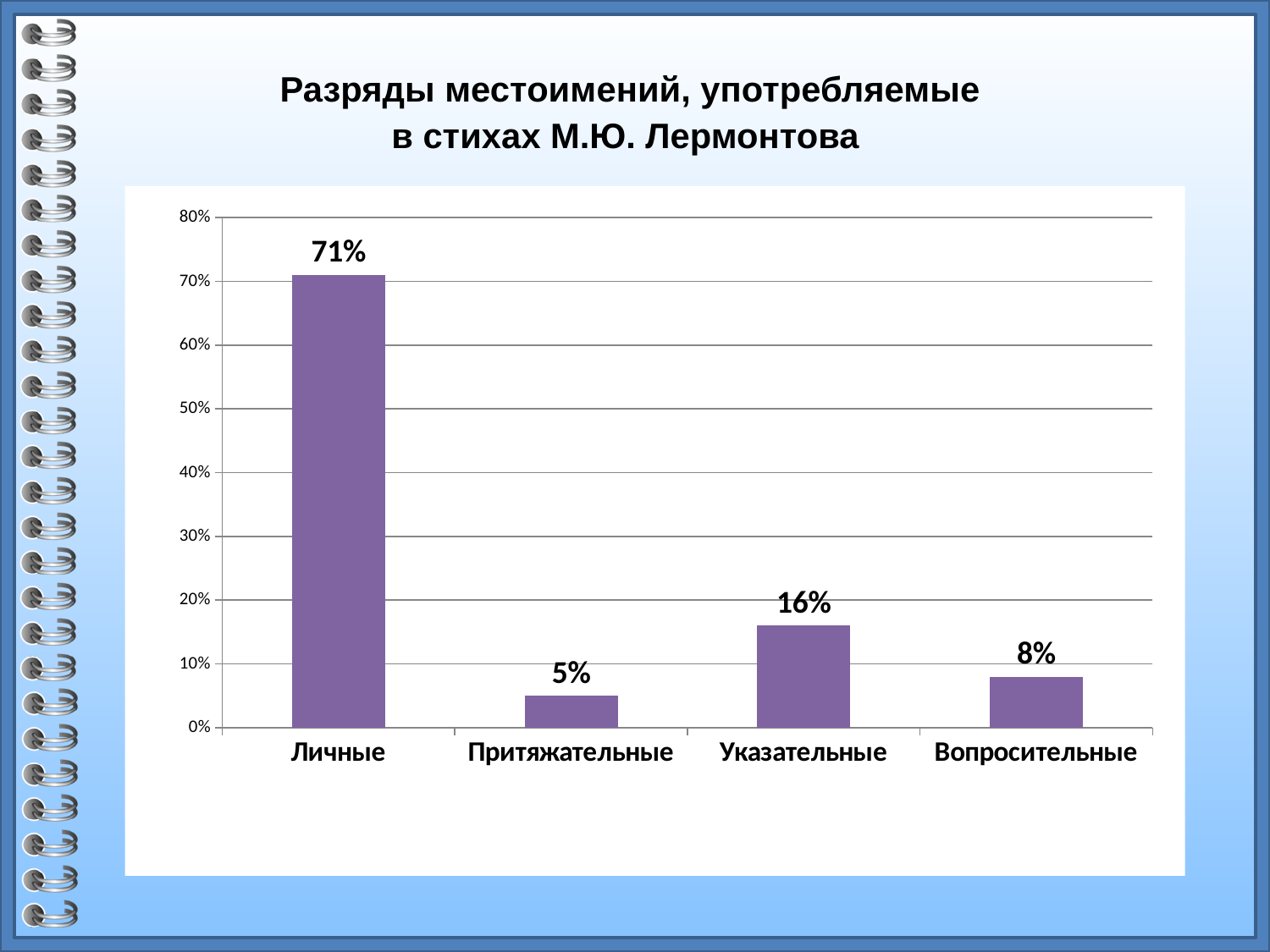
How many categories are shown on the x axis? 4 What is the value for Притяжательные? 5% Which is larger, the value for Указательные or the value for Вопросительные? Указательные Which category has the highest value? Личные What is the difference between the values for Личные and Указательные? 55% What is the value for Вопросительные? 8% Which category has the lowest value? Притяжательные What kind of chart is shown on the slide? bar chart What is the difference between the values for Вопросительные and Притяжательные? 3% Is the value for Указательные greater or less than 20%? less What is the value for Личные? 71% What is the value for Указательные? 16%